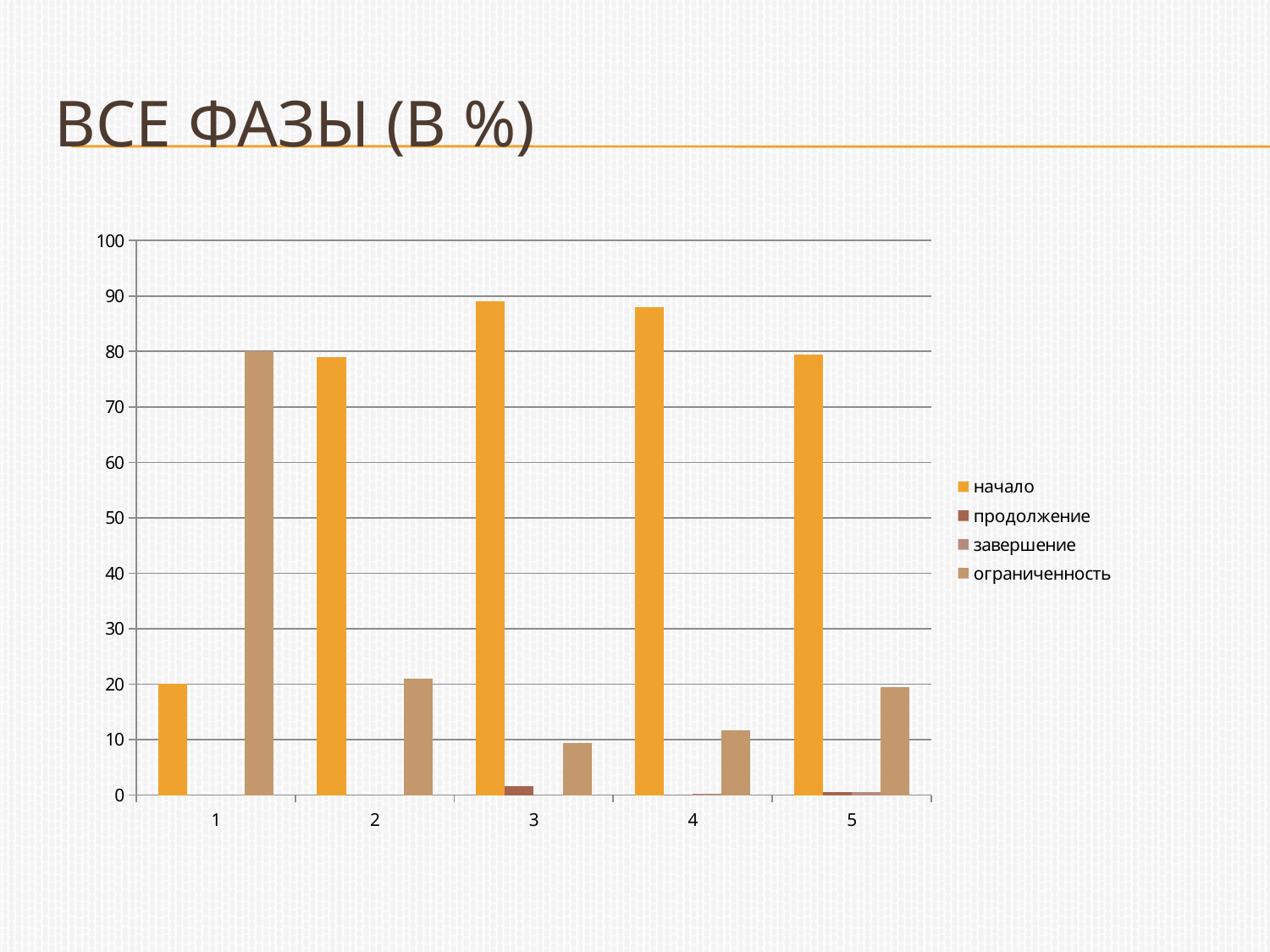
How many series does the legend list? 4 What is the value of ограниченность for category 1? 80 Is the value of начало for category 2 greater or less than 70? greater What kind of chart is shown on the slide? bar chart Which category has the highest value for ограниченность? 1 What is the title of the chart? ВСЕ ФАЗЫ (В %) Is the value of ограниченность for category 4 greater or less than 20? less Which category has the lowest value for начало? 1 For category 1, which is larger: начало or ограниченность? ограниченность Is the value of начало for category 3 greater or less than 80? greater What is the value of начало for category 1? 20 How many categories are shown on the x axis? 5